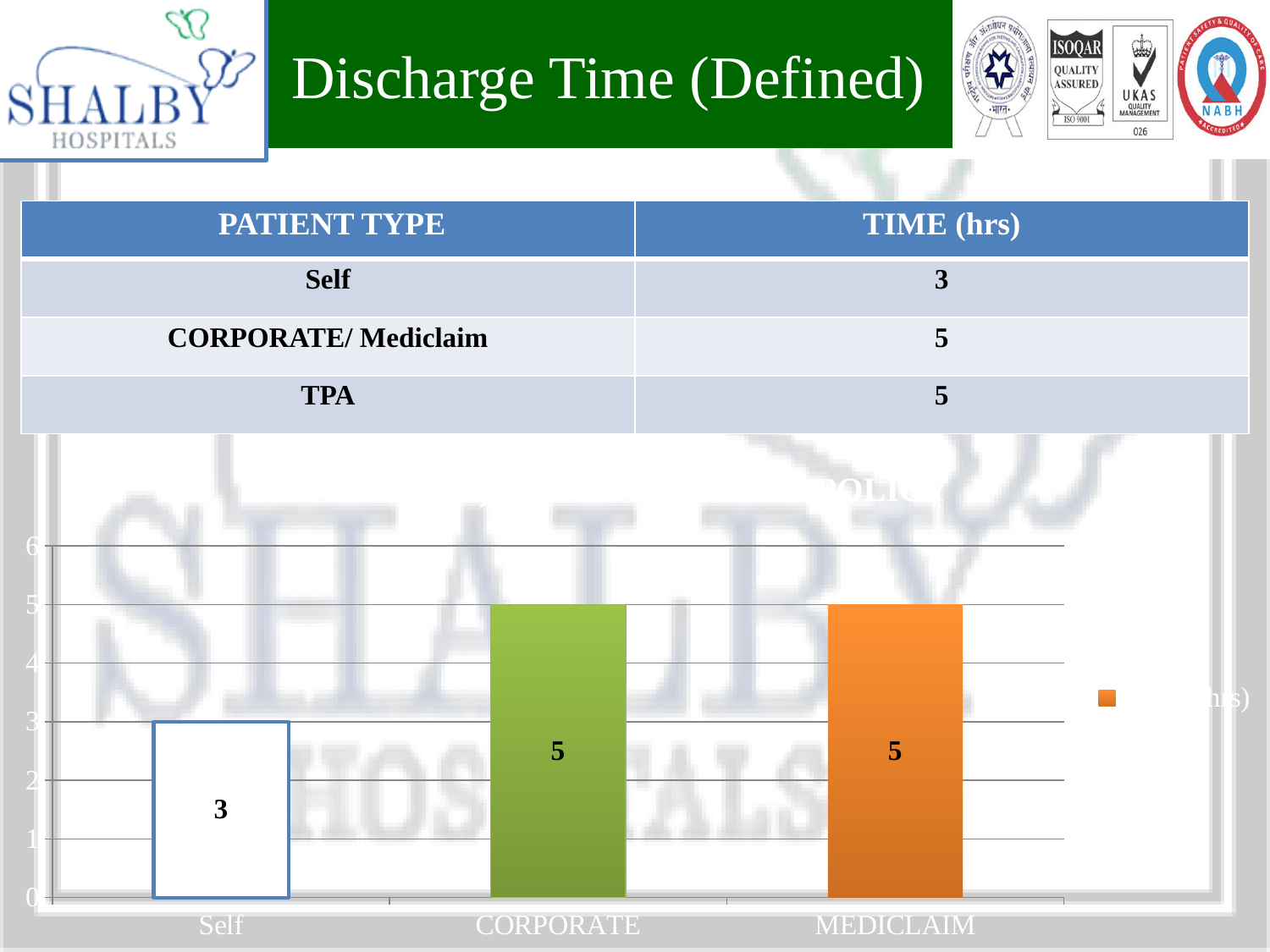
Do the values in the bar chart rise or fall from Self to CORPORATE? rise Which is larger in the bar chart, the value for Self or the value for MEDICLAIM? MEDICLAIM What is the difference between the values for CORPORATE and Self in the bar chart? 2 What is the highest value shown on the y axis of the bar chart? 6 What kind of chart is shown on the slide? bar chart What is the value for MEDICLAIM in the bar chart? 5 Which category has the lowest value in the bar chart? Self How many categories are shown on the x axis of the bar chart? 3 Is the value for CORPORATE in the bar chart greater or less than 4? greater What is the value for Self in the bar chart? 3 Is the value for Self in the bar chart greater or less than 4? less What is the value for CORPORATE in the bar chart? 5